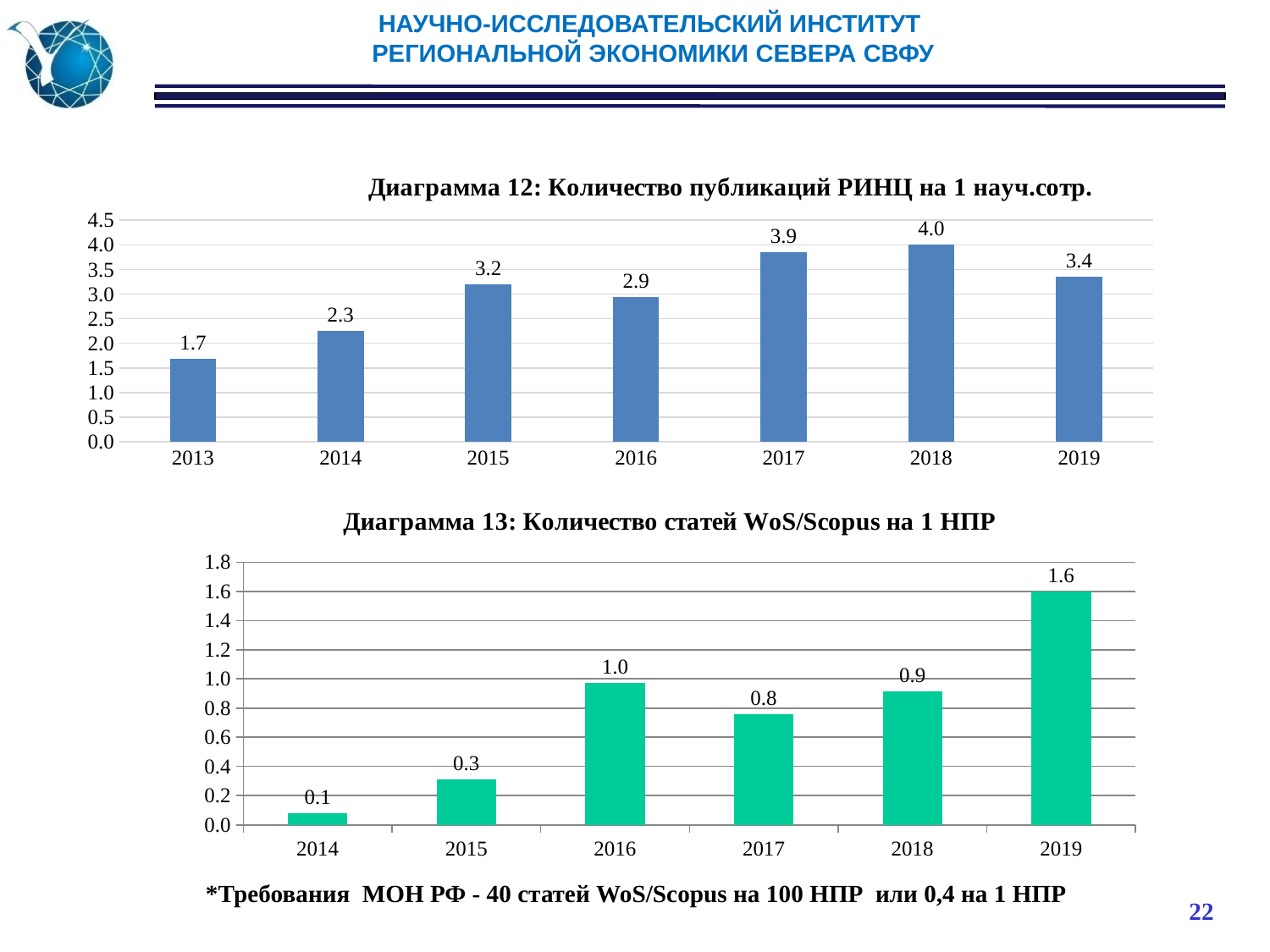
In the chart 'Диаграмма 12: Количество публикаций РИНЦ на 1 науч.сотр.', how many years are shown? 7 In the chart 'Диаграмма 13: Количество статей WoS/Scopus на 1 НПР', what is the difference between the values for 2019 and 2018? 0.7 In the chart 'Диаграмма 12: Количество публикаций РИНЦ на 1 науч.сотр.', which year has the lowest value? 2013 In the chart 'Диаграмма 12: Количество публикаций РИНЦ на 1 науч.сотр.', what is the difference between the values for 2018 and 2013? 2.3 What type of chart is 'Диаграмма 13: Количество статей WoS/Scopus на 1 НПР'? Bar chart In the chart 'Диаграмма 13: Количество статей WoS/Scopus на 1 НПР', what is the value for 2017? 0.8 In the chart 'Диаграмма 13: Количество статей WoS/Scopus на 1 НПР', how many years are shown? 6 In the chart 'Диаграмма 12: Количество публикаций РИНЦ на 1 науч.сотр.', which year has the highest value? 2018 In the chart 'Диаграмма 12: Количество публикаций РИНЦ на 1 науч.сотр.', which is larger, the value for 2016 or the value for 2017? 2017 In the chart 'Диаграмма 13: Количество статей WoS/Scopus на 1 НПР', which year has the highest value? 2019 In the chart 'Диаграмма 13: Количество статей WoS/Scopus на 1 НПР', which year has the lowest value? 2014 In the chart 'Диаграмма 12: Количество публикаций РИНЦ на 1 науч.сотр.', what is the value for 2015? 3.2